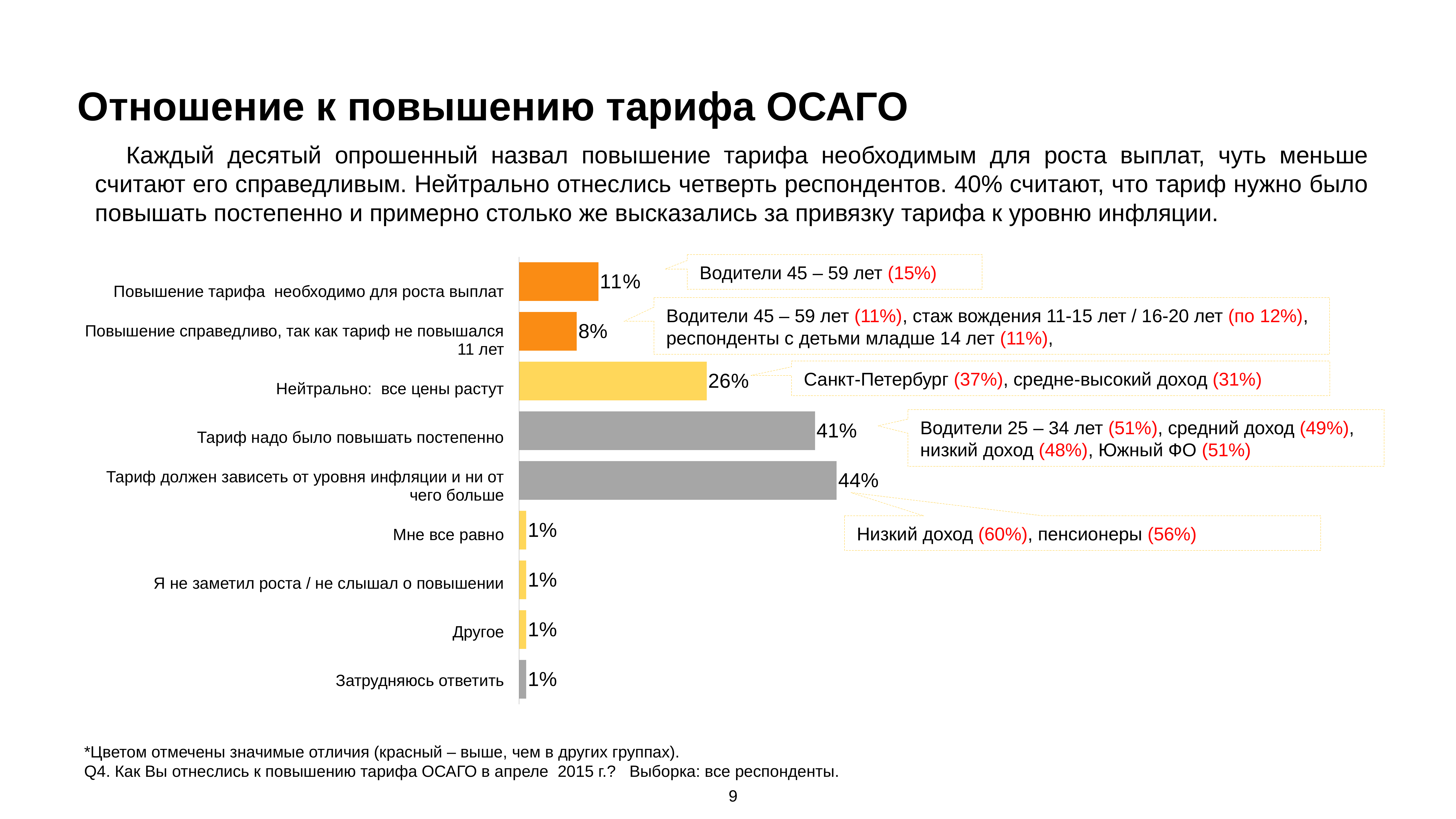
How many response categories have a value of 1%? 4 What type of chart is shown on the slide? Bar chart Which is larger: "Повышение тарифа необходимо для роста выплат" or "Повышение справедливо, так как тариф не повышался 11 лет"? Повышение тарифа необходимо для роста выплат What is the value for "Тариф надо было повышать постепенно"? 41% What is the combined total of "Тариф надо было повышать постепенно" and "Тариф должен зависеть от уровня инфляции и ни от чего больше"? 85% What is the difference between "Тариф должен зависеть от уровня инфляции и ни от чего больше" and "Тариф надо было повышать постепенно"? 3% What is the value shown for "Нейтрально: все цены растут"? 26% What percentage is shown for "Повышение справедливо, так как тариф не повышался 11 лет"? 8% Which response option has the highest percentage? Тариф должен зависеть от уровня инфляции и ни от чего больше How many response categories are shown in the chart? 9 What is the difference between "Нейтрально: все цены растут" and "Повышение тарифа необходимо для роста выплат"? 15% What percentage of respondents chose "Тариф должен зависеть от уровня инфляции и ни от чего больше"? 44%